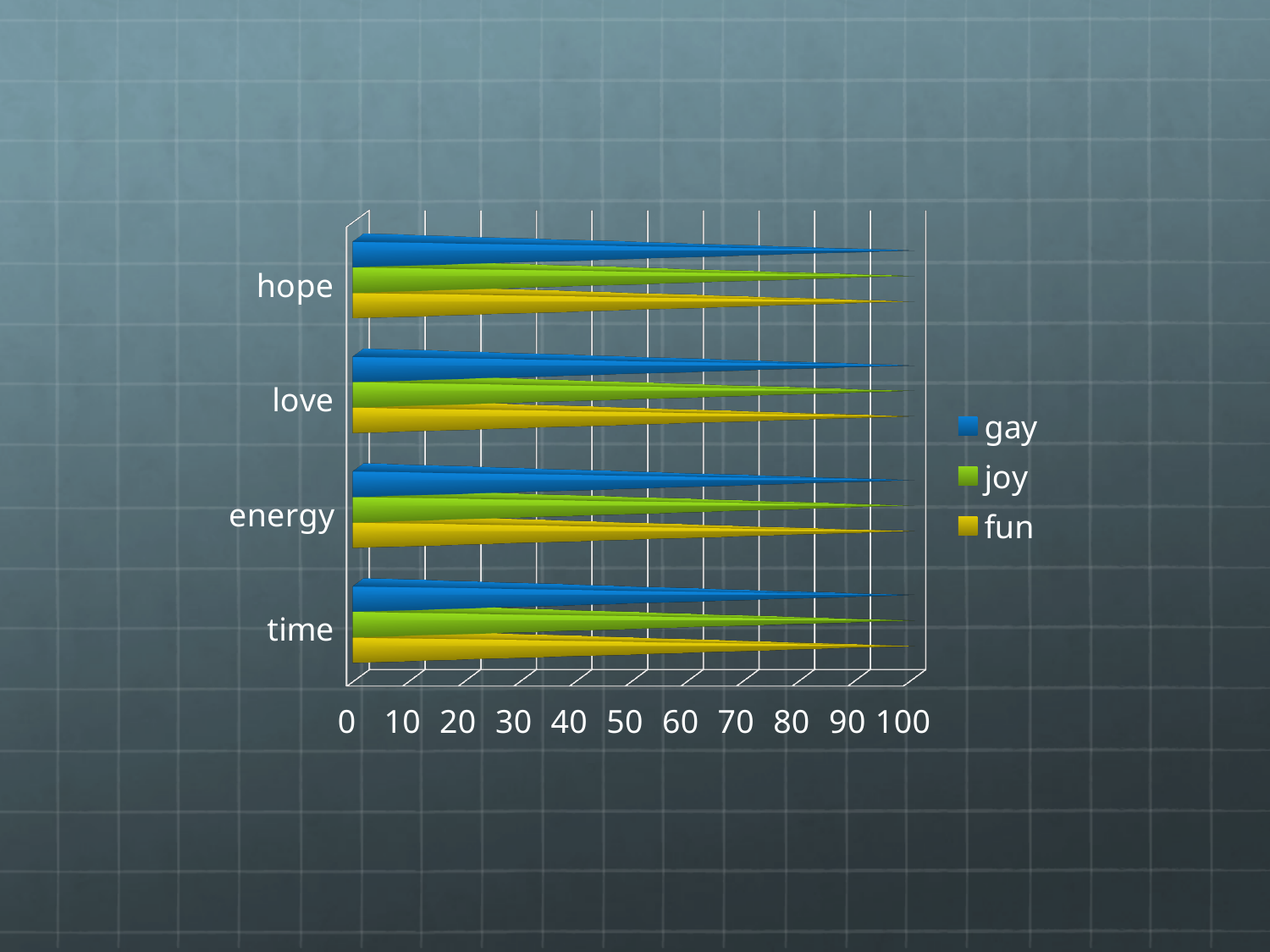
How many categories are shown on the vertical axis of the chart? 4 What kind of chart is shown on the slide? bar chart Which category appears at the top of the chart's vertical axis? hope What are the series names listed in the chart's legend? gay, joy, fun Is the value for 'gay' in the 'love' category greater or less than 70? greater Is the value for 'joy' in the 'energy' category greater or less than 60? greater Is the value for 'gay' in the 'hope' category greater or less than 50? greater What is the highest value shown on the chart's horizontal axis? 100 How many series does the chart's legend list? 3